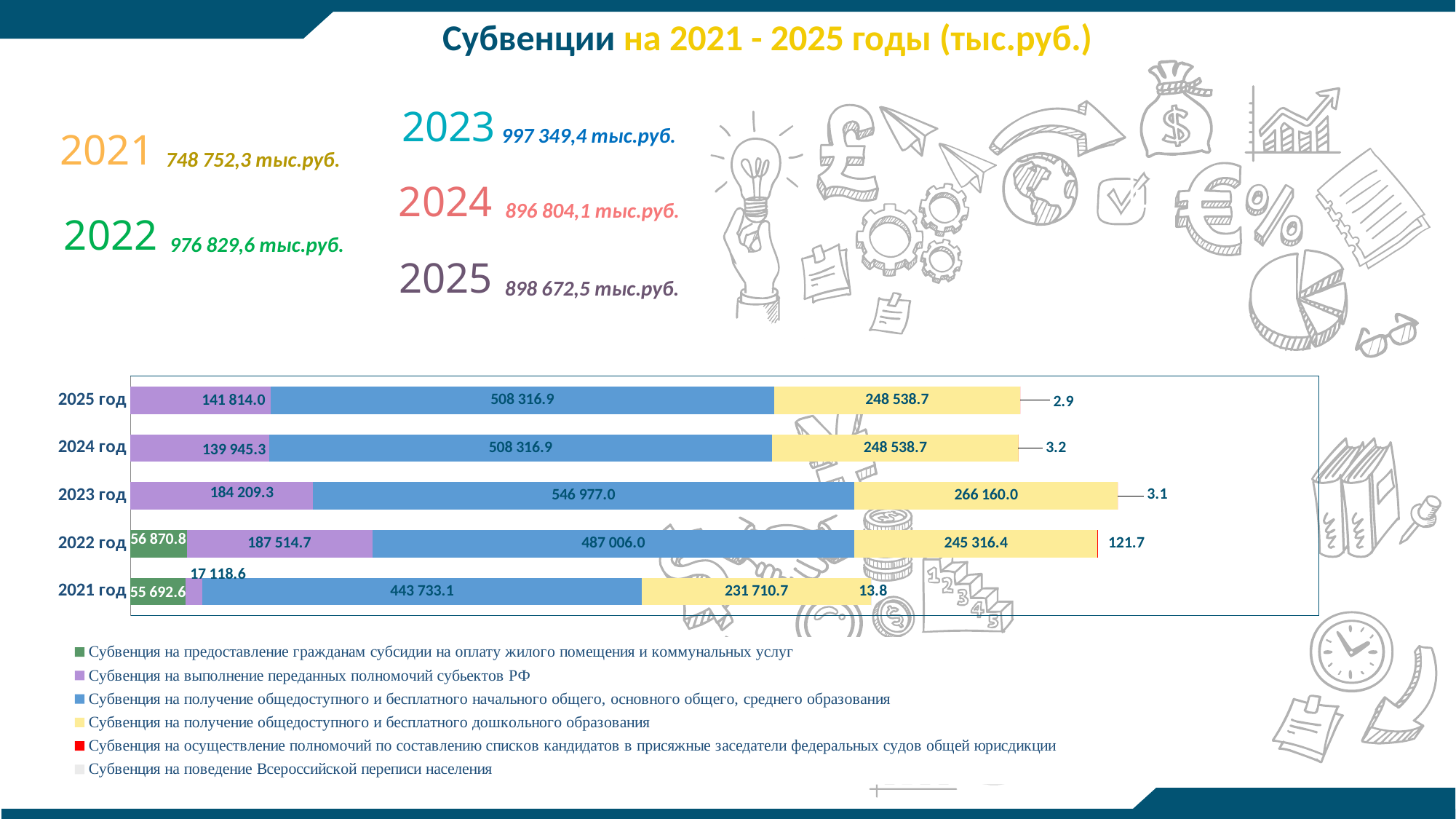
What is the difference between the purple series values for 2025 год and 2024 год? 1 868.7 How many year categories are plotted in the chart? 5 What type of chart is shown on the slide? Stacked bar chart What is the total of the stacked bar for 2025 год? 898 672.5 Which is larger: the yellow series value for 2023 год or for 2022 год? 2023 год What is the title of the slide above the chart? Субвенции на 2021 - 2025 годы (тыс.руб.) How many series does the chart legend list? 6 In which year is the purple series (выполнение переданных полномочий субъектов РФ) lowest? 2021 год What is the value of the purple series (Субвенция на выполнение переданных полномочий субъектов РФ) for 2025 год? 141 814.0 What is the value of the blue series (Субвенция на получение общедоступного и бесплатного начального общего, основного общего, среднего образования) for 2023 год? 546 977.0 In which year is the blue series (начального общего, основного общего, среднего образования) highest? 2023 год What is the value of the yellow series (Субвенция на получение общедоступного и бесплатного дошкольного образования) for 2021 год? 231 710.7